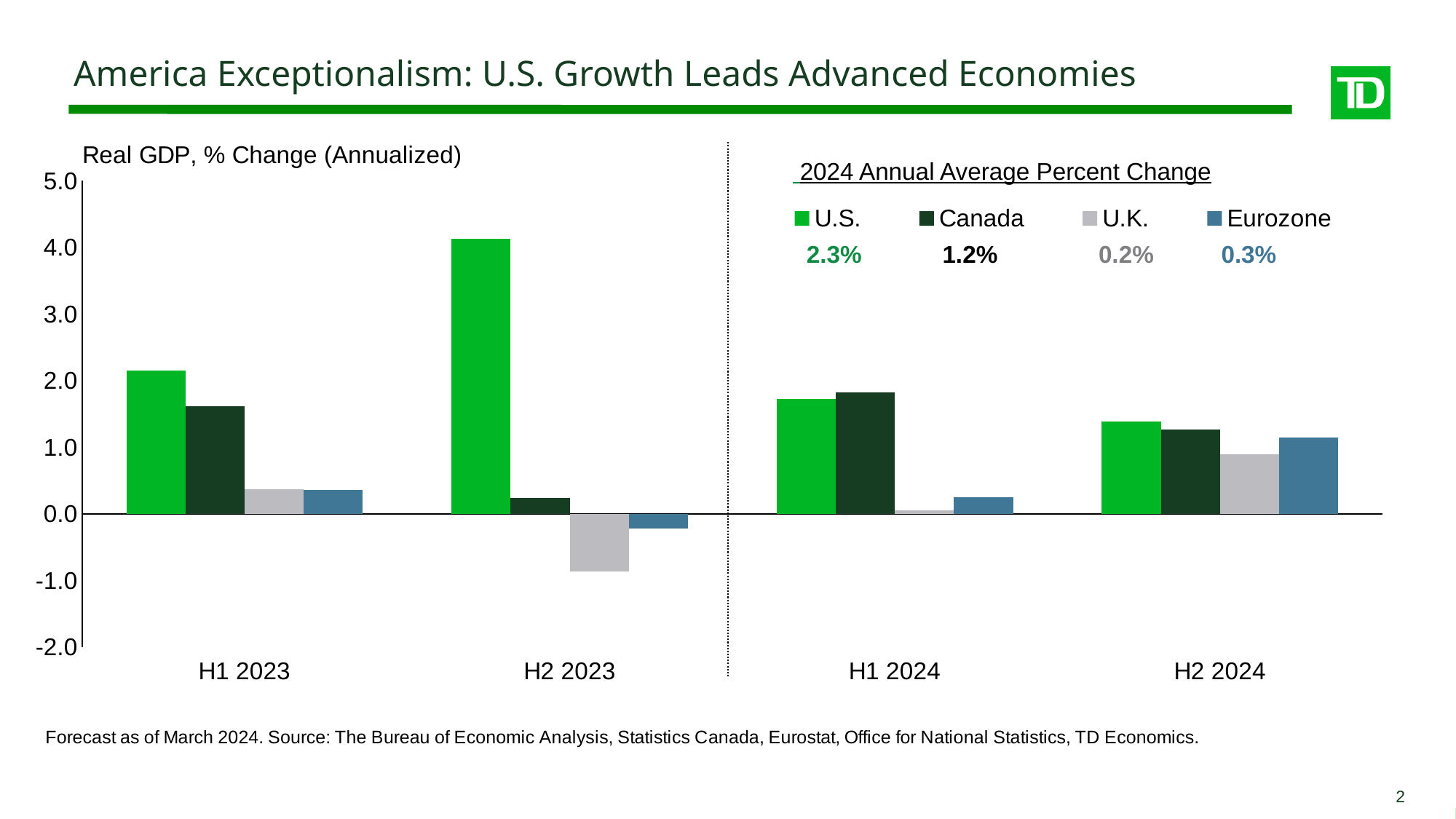
Is the U.K. value for H2 2023 greater or less than 0.0? less What is the 2024 annual average percent change shown for the Eurozone? 0.3% What is the 2024 annual average percent change shown for Canada? 1.2% How many series does the legend list? 4 What is the 2024 annual average percent change shown for the U.K.? 0.2% Which economy has the highest 2024 annual average percent change? U.S. How many time periods are shown on the x axis? 4 Which economy has the lowest bar in H2 2023? U.K. Is the U.S. value for H2 2023 greater or less than 3.0? greater What is the 2024 annual average percent change shown for the U.S.? 2.3% What kind of chart is shown on the slide? bar chart In H2 2024, which is larger, the U.S. bar or the U.K. bar? U.S.